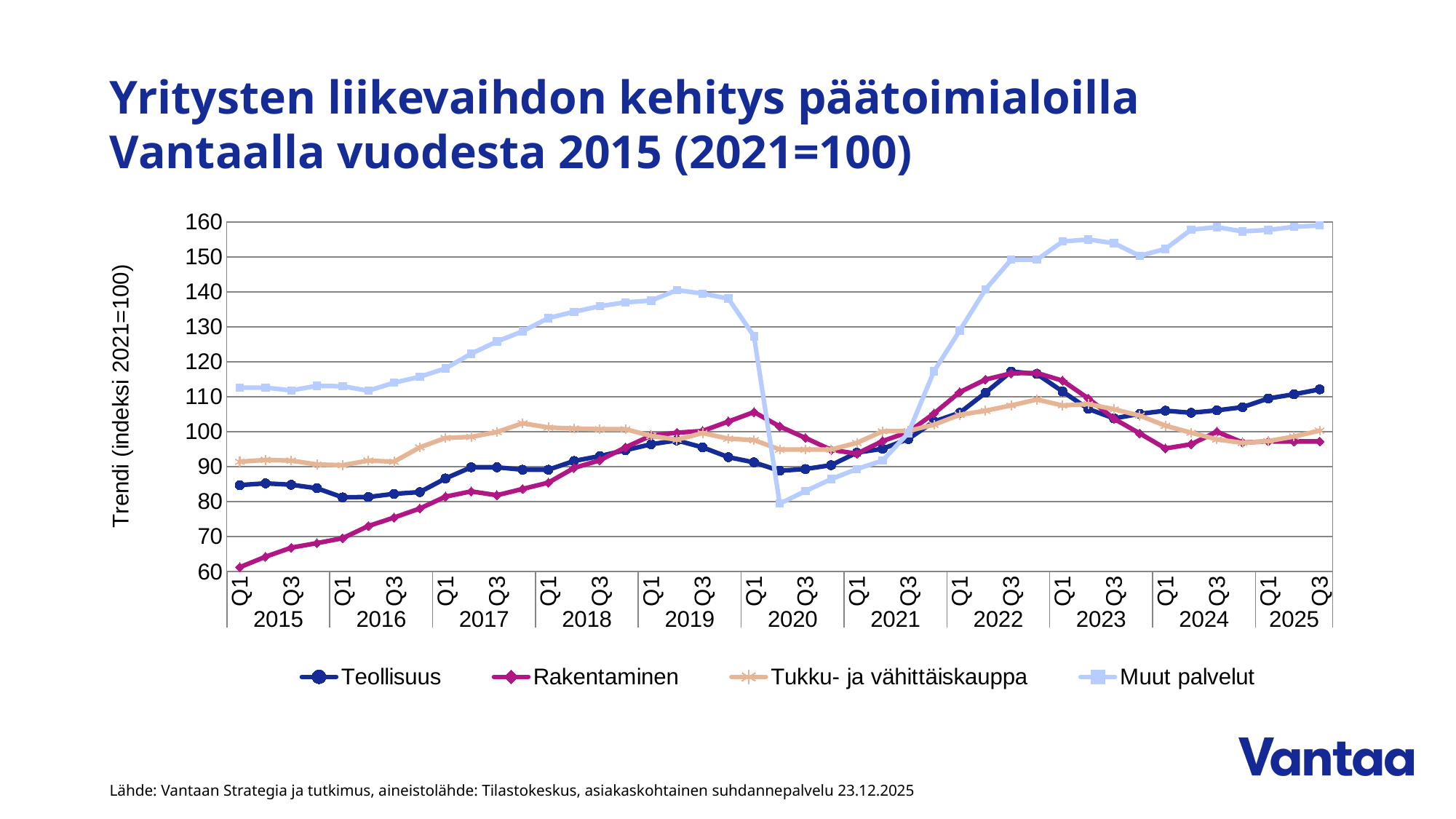
What kind of chart is shown on the slide? line chart Does the Rakentaminen series rise or fall from Q1 2015 to Q3 2019? rise How many series does the legend list? 4 Which series has the lowest value in Q1 2015? Rakentaminen Is the value for Muut palvelut in Q2 2020 greater or less than 90? less What is the title of the vertical axis? Trendi (indeksi 2021=100) Is the value for Teollisuus in Q3 2022 greater or less than 110? greater Is the value for Muut palvelut in Q3 2025 greater or less than 150? greater Which series has the highest value in Q3 2025? Muut palvelut In Q3 2025, which series has the higher value, Teollisuus or Rakentaminen? Teollisuus Which series are listed in the legend? Teollisuus, Rakentaminen, Tukku- ja vähittäiskauppa, Muut palvelut